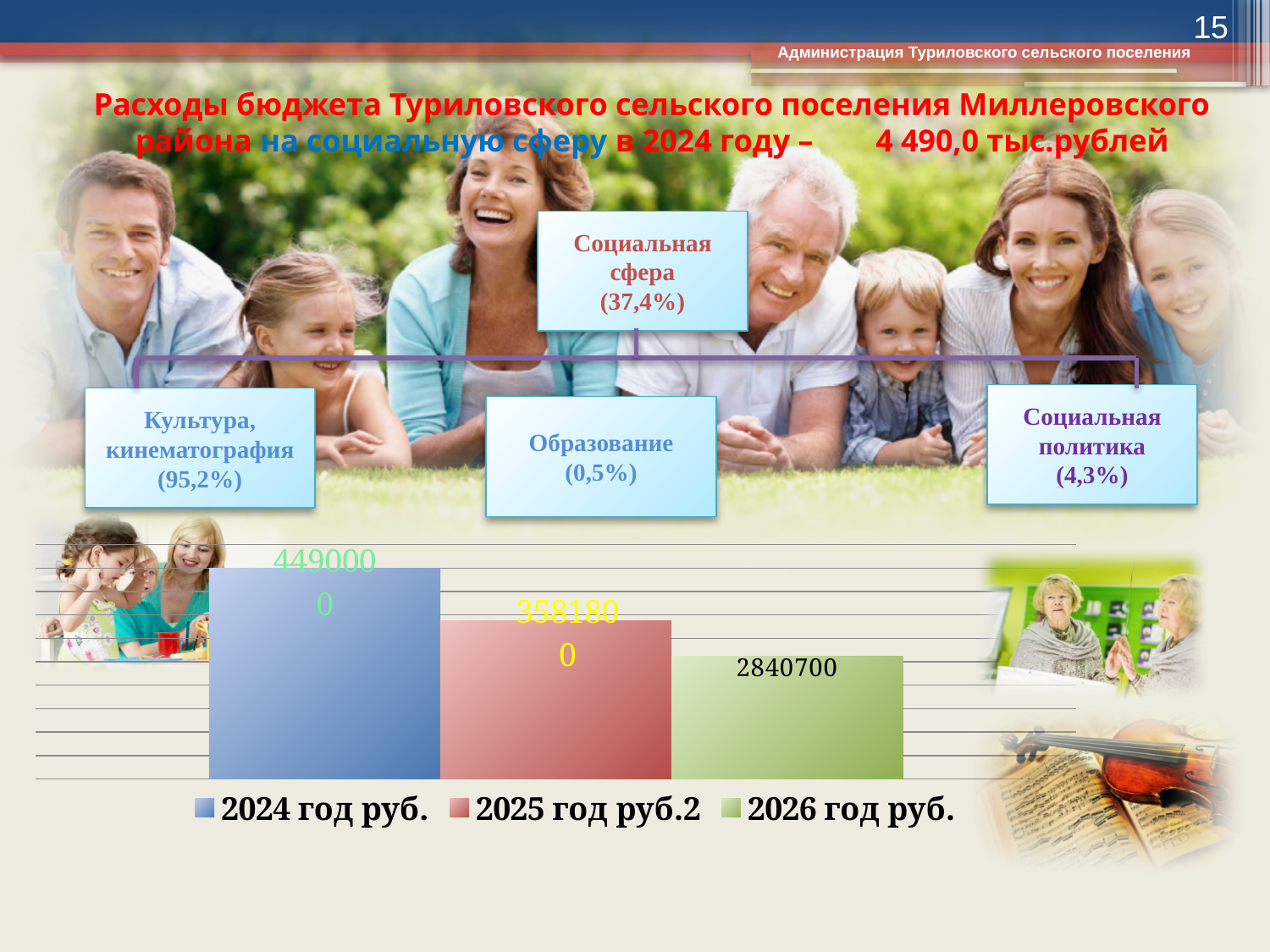
Which series has the lowest value in the chart? 2026 год руб. What value is shown for the 2024 год руб. bar in the chart? 4490000 What value is shown for the 2025 год руб.2 bar in the chart? 3581800 Do the values rise or fall from the 2024 bar to the 2026 bar? fall What is the difference between the 2024 год руб. value and the 2025 год руб.2 value? 908200 What kind of chart is shown on the slide? bar chart How many series does the chart legend list? 3 What value is shown for the 2026 год руб. bar in the chart? 2840700 What is the difference between the 2025 год руб.2 value and the 2026 год руб. value? 741100 How many bars are plotted in the chart? 3 Which series has the highest value in the chart? 2024 год руб. Which is larger, the 2024 год руб. value or the 2026 год руб. value? 2024 год руб.